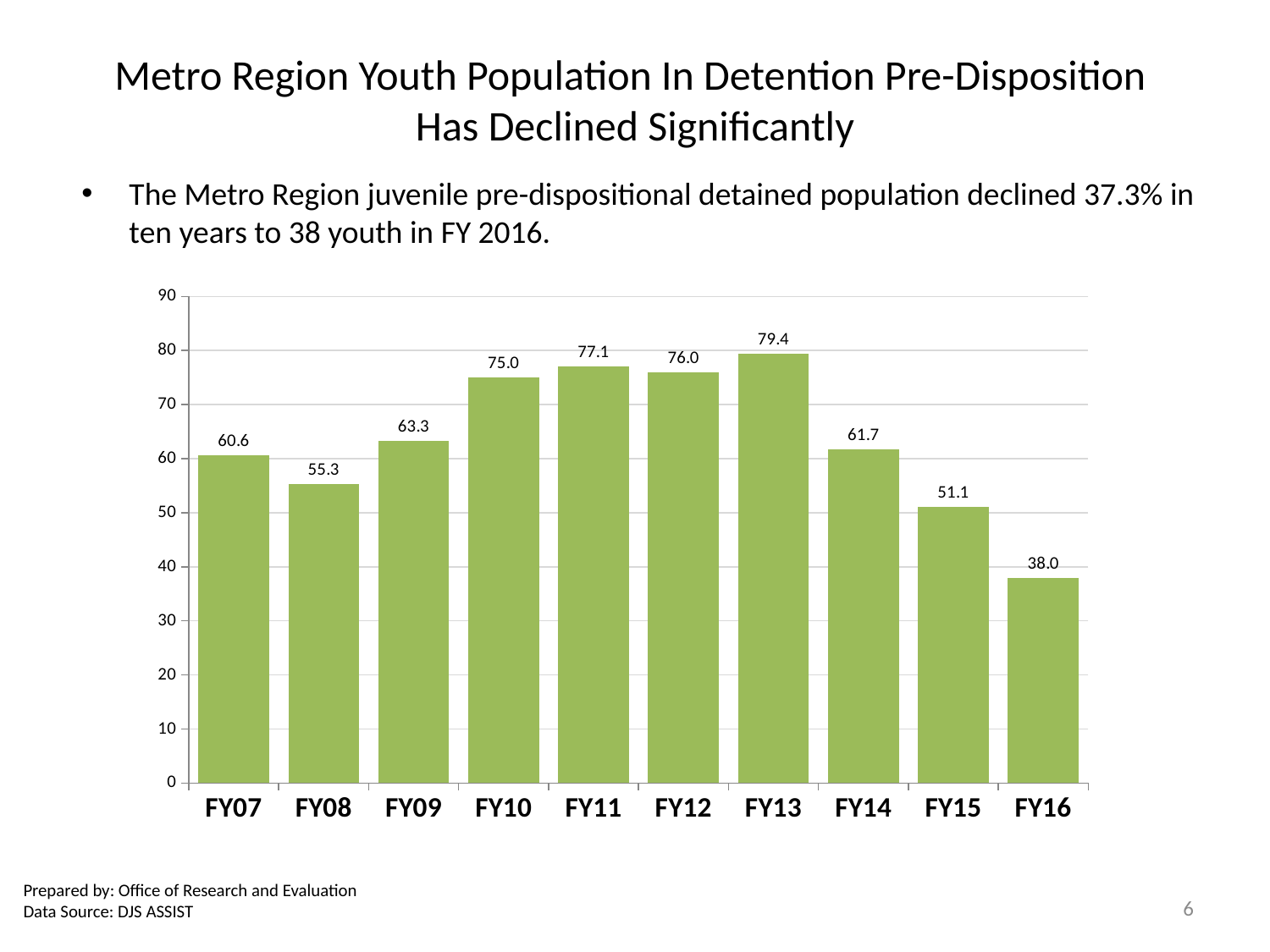
Do the values rise or fall from FY13 to FY16? fall What is the value for FY07? 60.6 What is the difference between the values for FY13 and FY16? 41.4 What colour are the bars in the chart? green How many fiscal years are shown on the x axis? 10 What is the value for FY13? 79.4 Which fiscal year has the lowest value? FY16 Is the value for FY15 greater or less than 60? less Which is larger, the value for FY10 or the value for FY12? FY12 What kind of chart is shown on the slide? bar chart What is the value for FY16? 38.0 Which fiscal year has the highest value? FY13